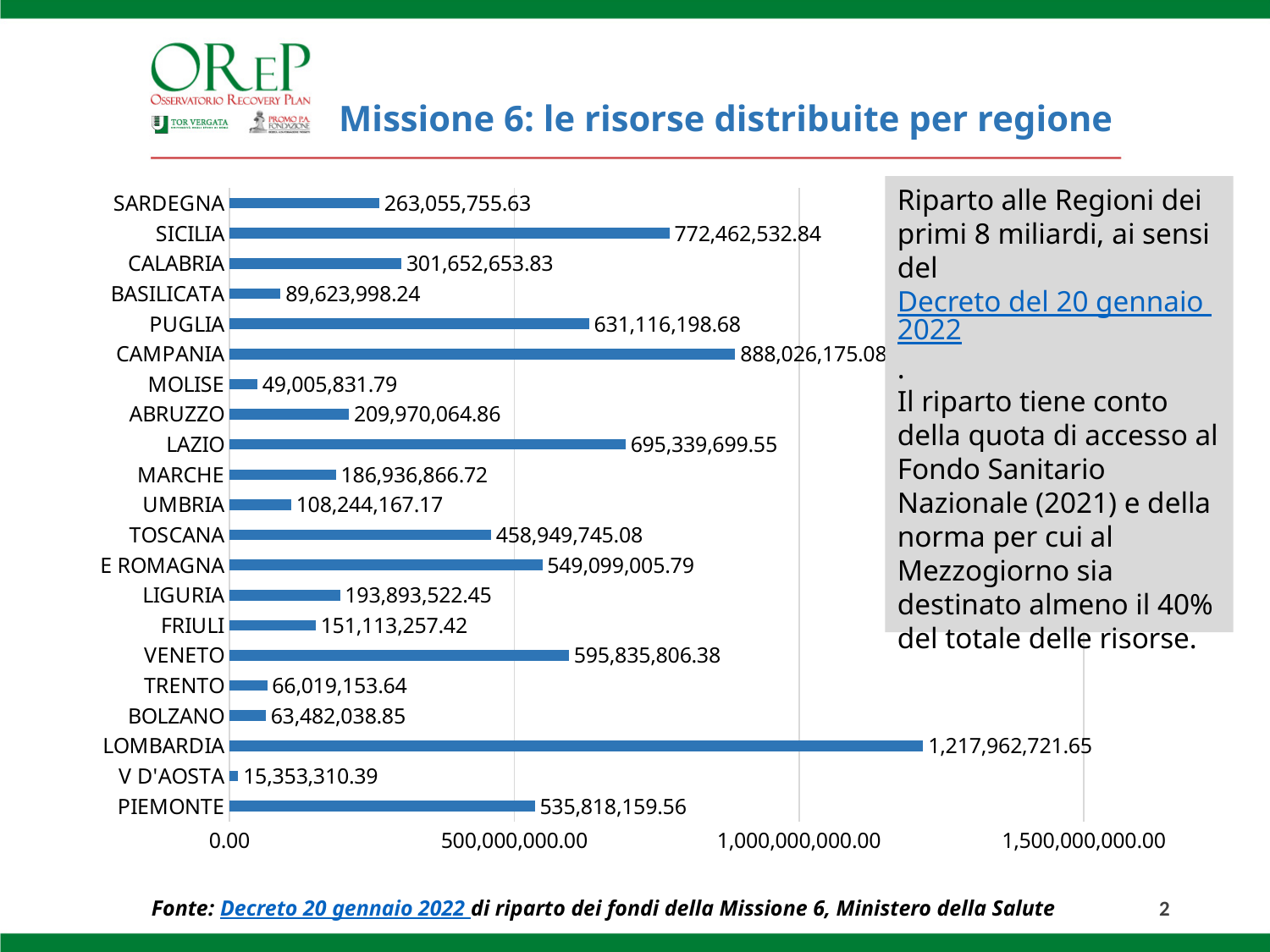
What is the value for LOMBARDIA? 1,217,962,721.65 What is the value for V D'AOSTA? 15,353,310.39 Is the value for LOMBARDIA greater or less than 1,000,000,000.00? greater What kind of chart is shown on the slide? bar chart What is the difference between the values for SICILIA and PUGLIA? 141,346,334.16 What is the value for CAMPANIA? 888,026,175.08 What is the difference between the values for LOMBARDIA and CAMPANIA? 329,936,546.57 Which region has the lowest value? V D'AOSTA Which has a larger value, VENETO or PIEMONTE? VENETO Which region has the highest value? LOMBARDIA How many regions are shown in the chart? 21 What is the value for TOSCANA? 458,949,745.08